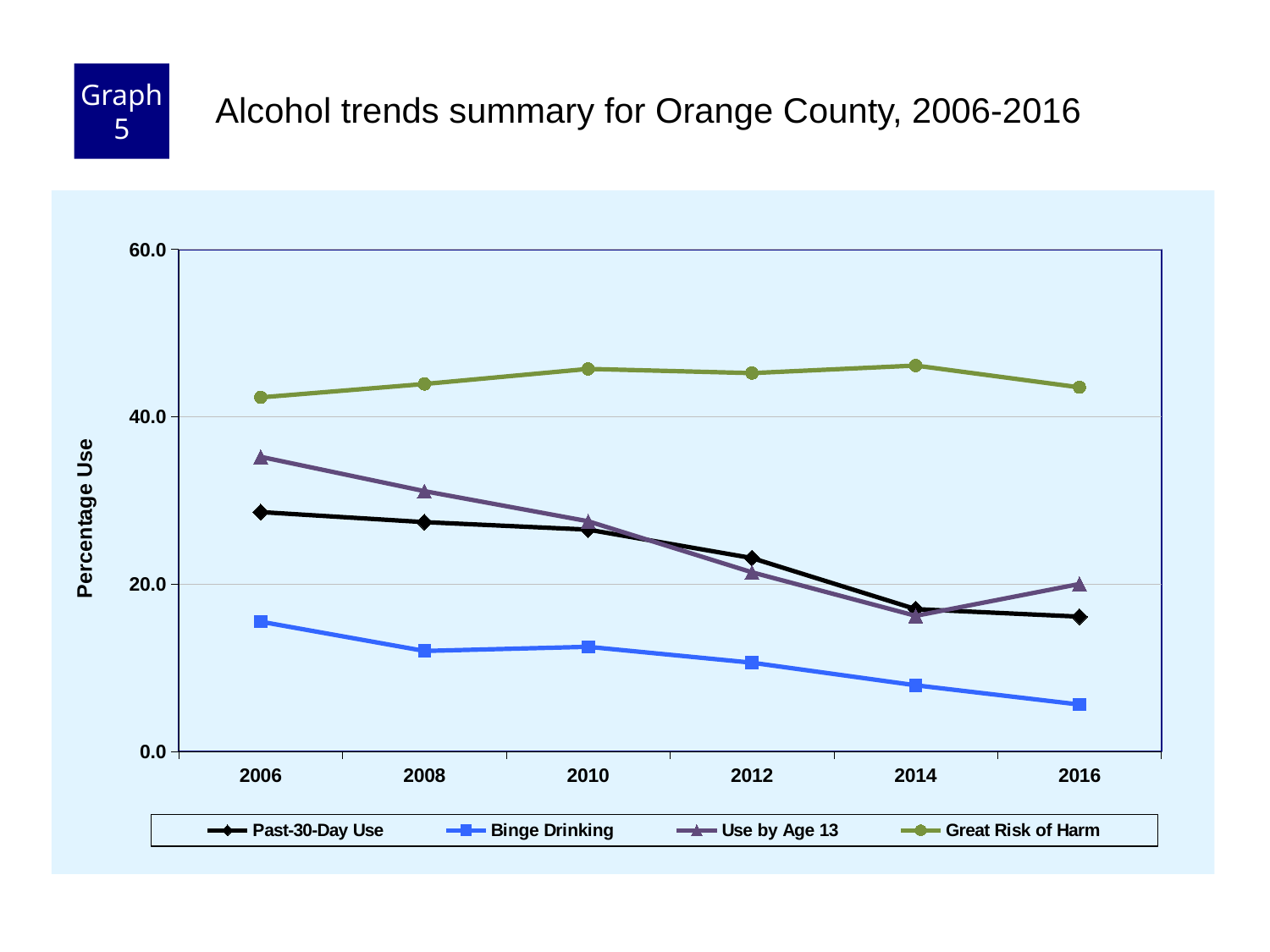
Is the value for Great Risk of Harm in 2010 greater or less than 40.0? greater Is the value for Binge Drinking in 2016 greater or less than 20.0? less Is the value for Use by Age 13 in 2006 greater or less than 40.0? less Which series has the highest value in 2012? Great Risk of Harm Which series has the lowest value in 2014? Binge Drinking Does the Binge Drinking series rise or fall from 2006 to 2016? Fall What is the label on the y axis? Percentage Use How many years are plotted along the x axis? 6 In 2006, which is larger: Use by Age 13 or Past-30-Day Use? Use by Age 13 How many series does the legend list? 4 What is the title of the slide's chart? Alcohol trends summary for Orange County, 2006-2016 What kind of chart is shown on the slide? Line chart